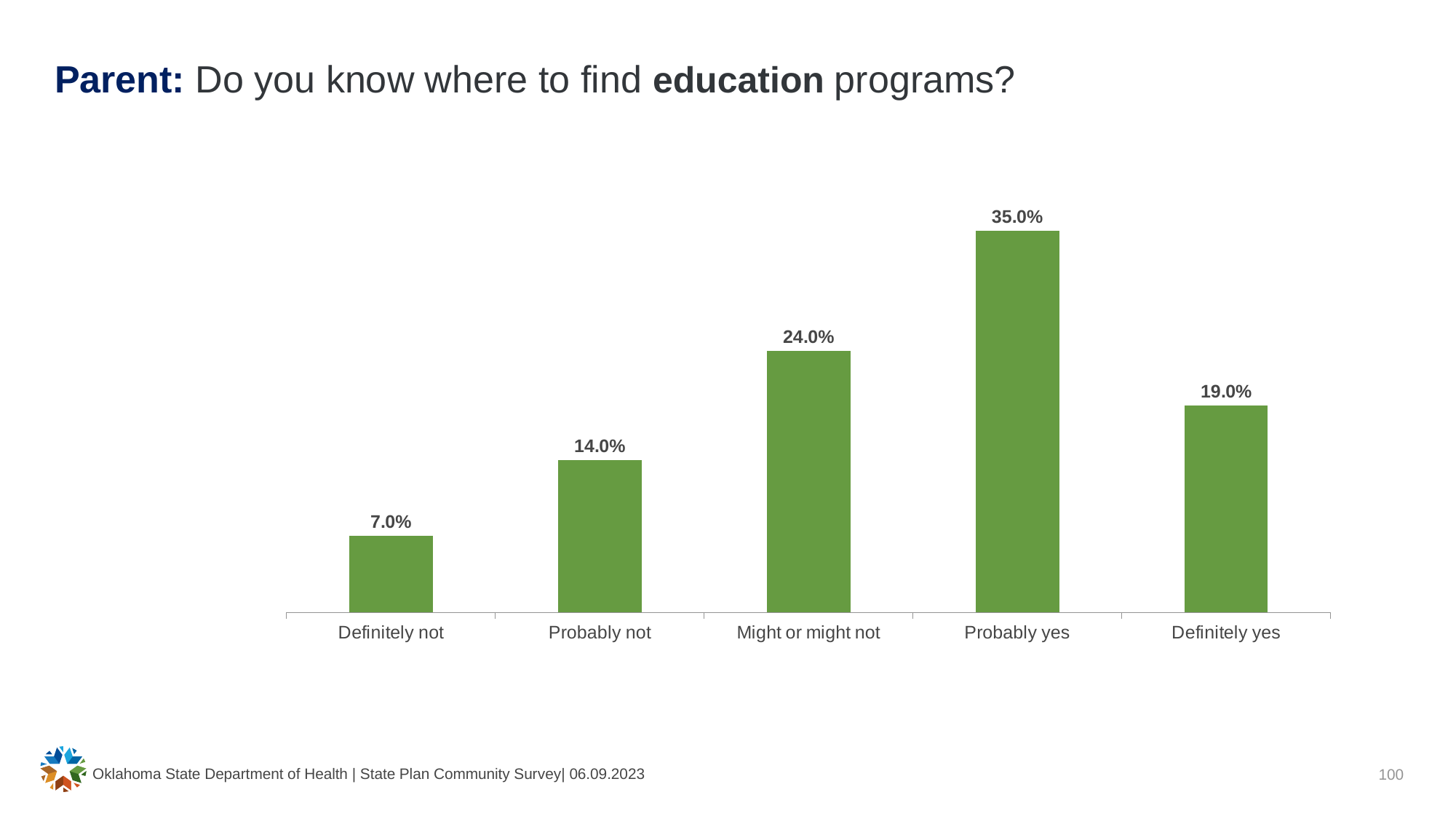
What is the value for "Definitely yes"? 19.0% What is the difference between the values for "Might or might not" and "Probably not"? 10.0% What is the value for "Definitely not"? 7.0% What is the difference between the values for "Probably yes" and "Definitely yes"? 16.0% What is the value for "Might or might not"? 24.0% What percentage of parents answered "Probably yes"? 35.0% Which is larger, the value for "Definitely yes" or the value for "Probably not"? Definitely yes How many response categories are shown on the chart? 5 What kind of chart is shown on the slide? Bar chart Which response category has the highest value? Probably yes What colour are the bars in the chart? Green Which response category has the lowest value? Definitely not